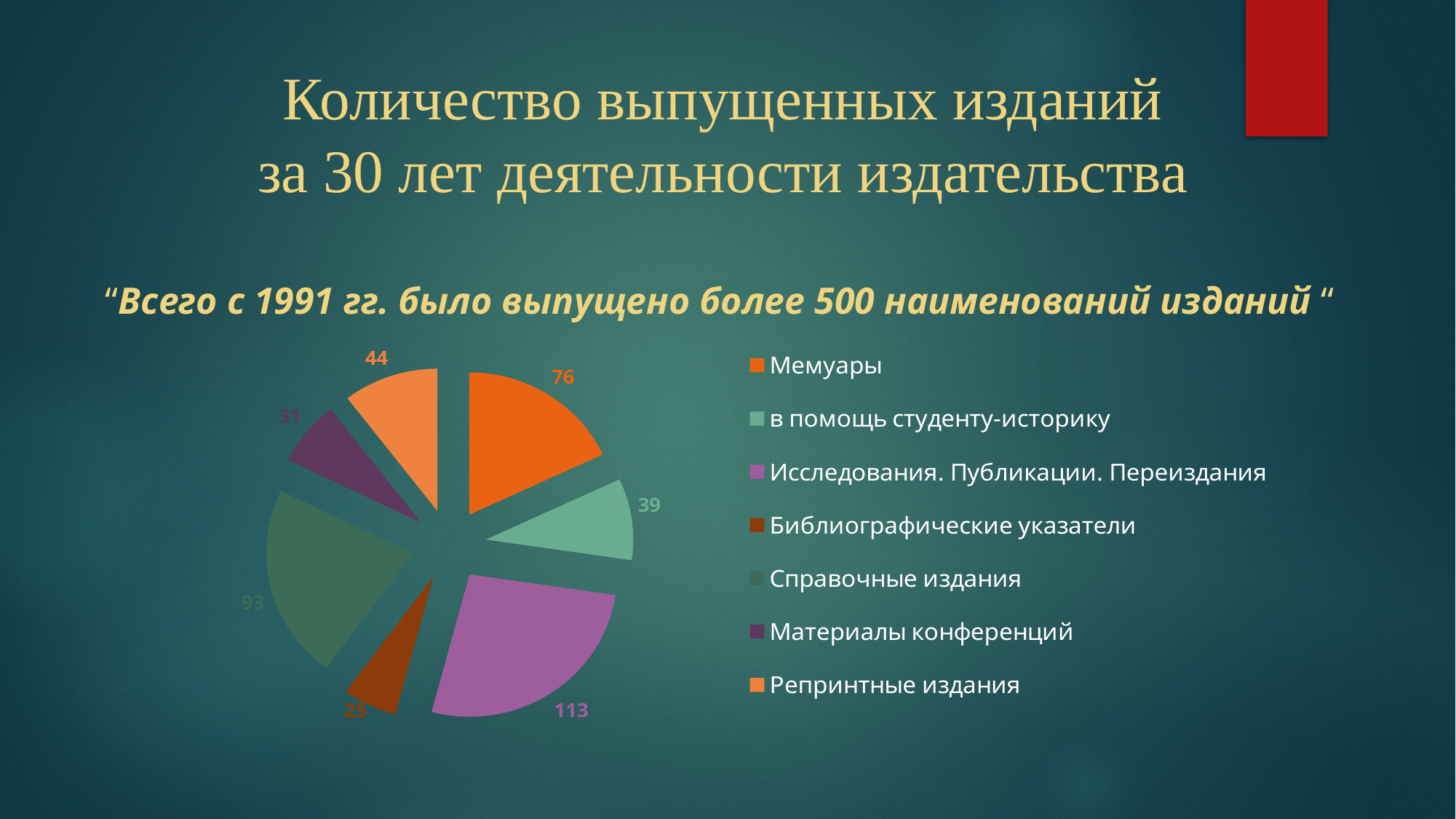
What is the difference between the values for Исследования. Публикации. Переиздания and Справочные издания? 20 How many slices does the pie chart have? 7 What is the value for Библиографические указатели? 25 Which category has the largest slice? Исследования. Публикации. Переиздания What is the value for Исследования. Публикации. Переиздания? 113 Which category has the smallest slice? Библиографические указатели What kind of chart is shown on the slide? pie chart What is the value for Мемуары? 76 What is the sum of all the values shown on the pie chart? 421 What is the value for Справочные издания? 93 Which is larger, the value for Репринтные издания or the value for в помощь студенту-историку? Репринтные издания